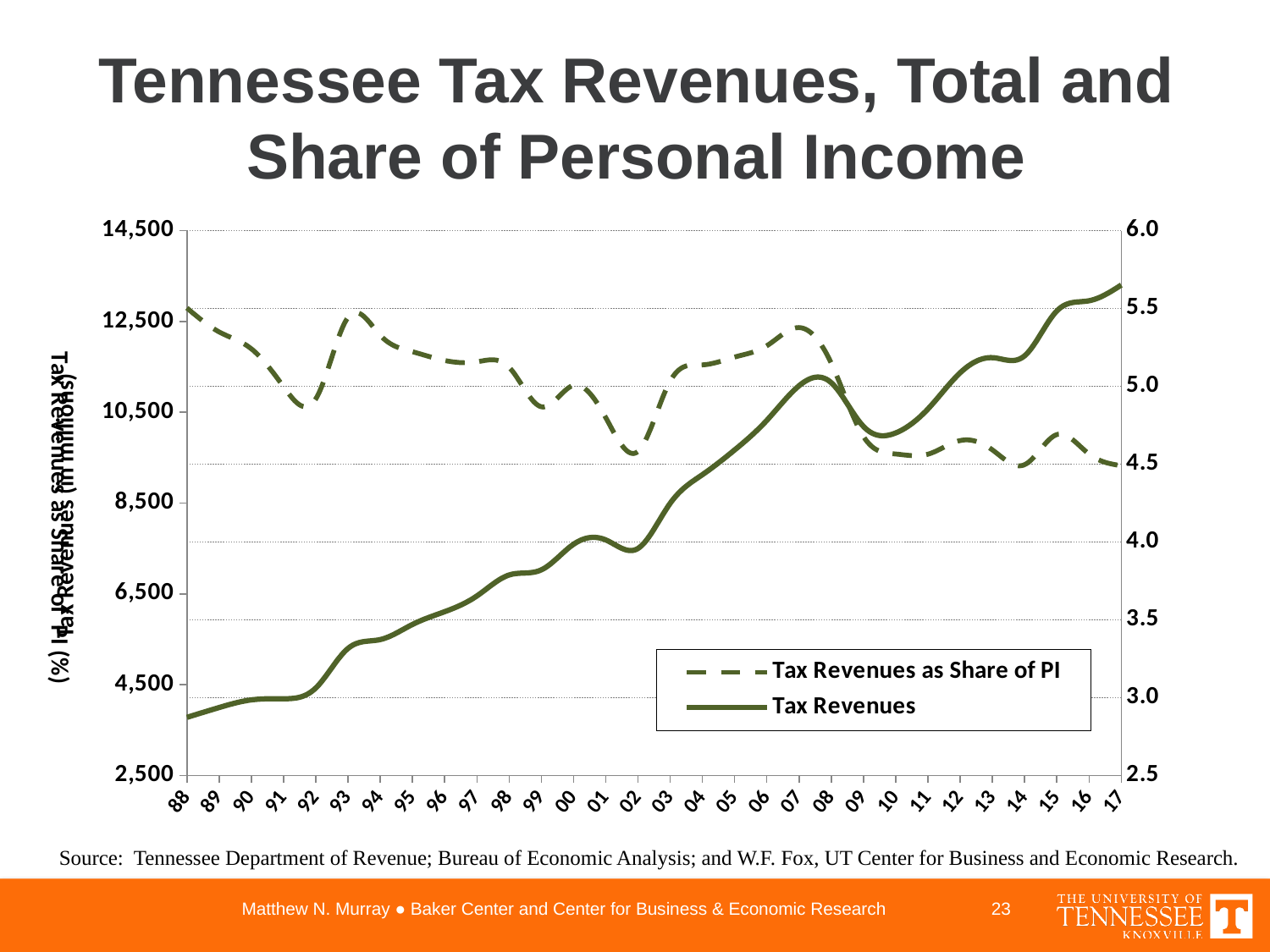
How many years are plotted along the x axis? 30 What is the title of the chart? Tennessee Tax Revenues, Total and Share of Personal Income Which year has the larger Tax Revenues value, 07 or 09? 07 Does the Tax Revenues series generally rise or fall from 88 to 17? rise Is the Tax Revenues value for 17 greater or less than 12,500? greater How many series does the legend list? 2 In which year is the Tax Revenues series lowest? 88 What kind of chart is shown on the slide? line chart Is the Tax Revenues as Share of PI value for 07 greater or less than 5.0? greater Which series is drawn with a dashed line? Tax Revenues as Share of PI In which year is the Tax Revenues series highest? 17 Is the Tax Revenues value for 88 greater or less than 4,500? less